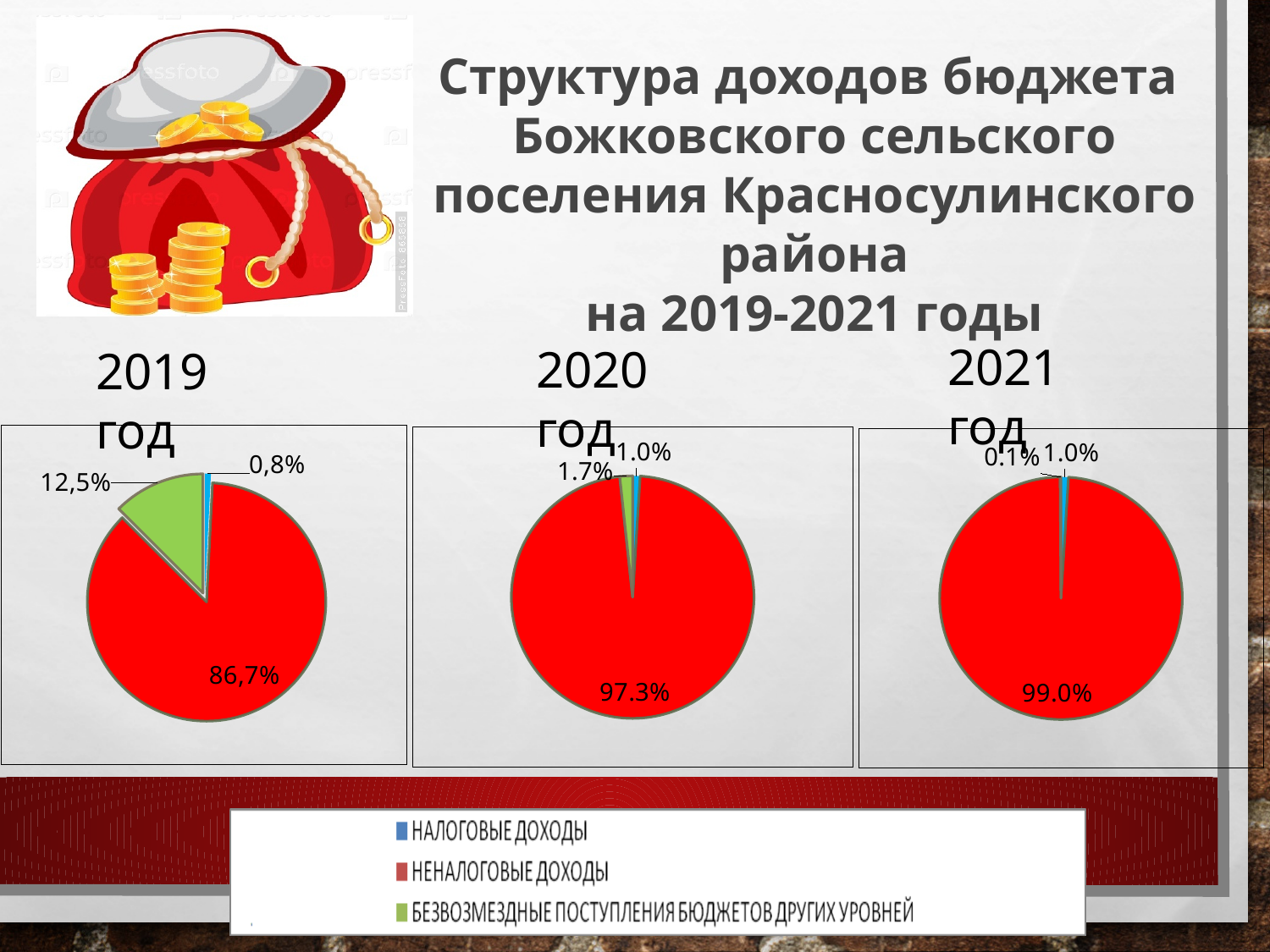
Which legend entry is shown in green? БЕЗВОЗМЕЗДНЫЕ ПОСТУПЛЕНИЯ БЮДЖЕТОВ ДРУГИХ УРОВНЕЙ In the 2021 год pie chart, what is the share of the largest slice? 99.0% In the 2019 год pie chart, what is the share of the green slice? 12,5% In the 2020 год pie chart, what is the share of the largest slice? 97.3% What kind of charts are shown on the slide? Pie charts How many pie charts are on the slide? 3 Which legend entry is shown in red? НЕНАЛОГОВЫЕ ДОХОДЫ In the 2019 год pie chart, what is the share of the smallest slice? 0,8% In the 2021 год pie chart, what is the share of the smallest slice? 0.1% How many entries does the legend list? 3